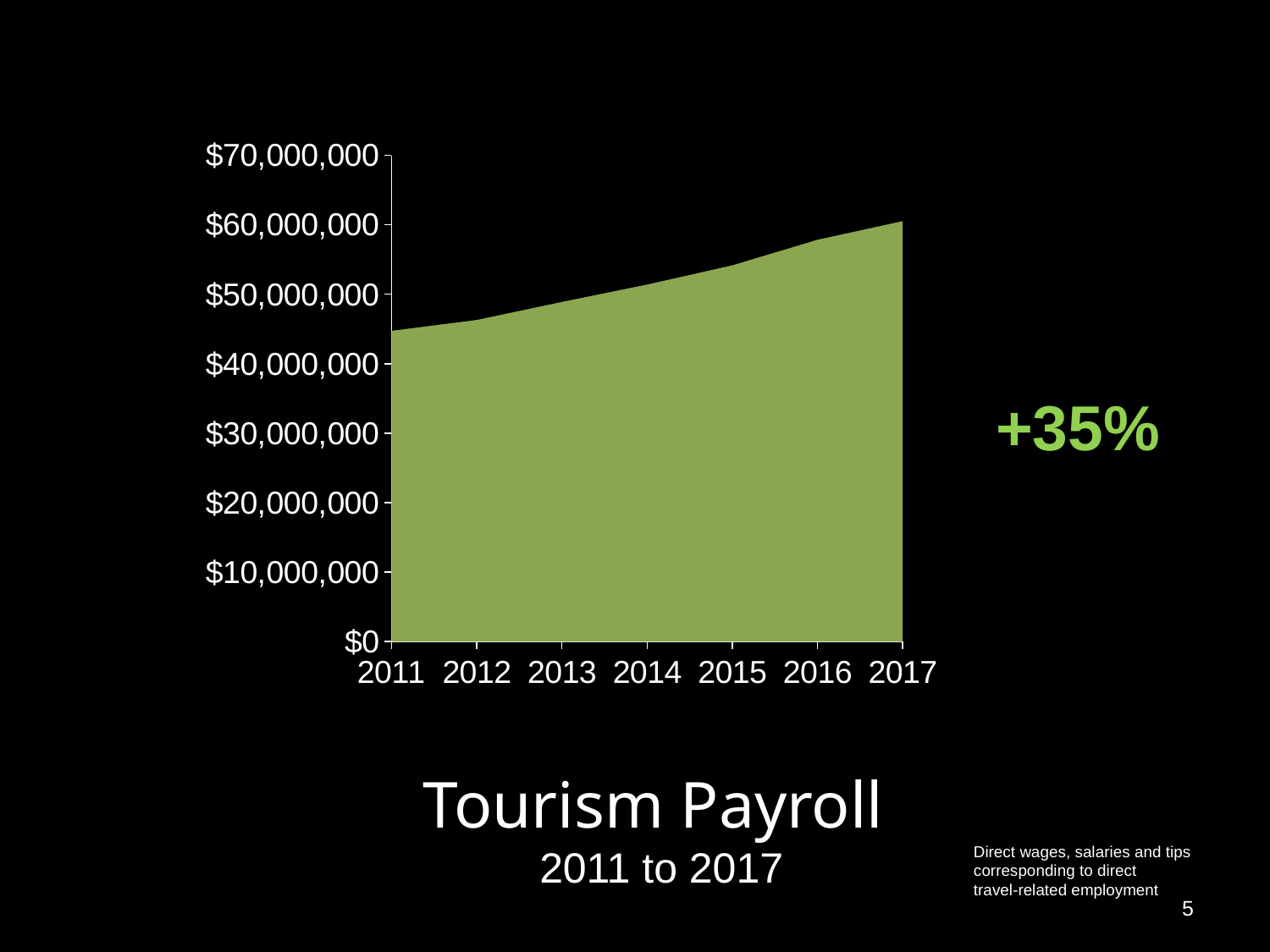
Which year has the highest tourism payroll? 2017 How many years are plotted along the x axis? 7 What is the title of the chart? Tourism Payroll 2011 to 2017 Which year has the lowest tourism payroll? 2011 What percentage change is annotated next to the chart? +35% Is the value for 2014 greater or less than $60,000,000? less Is the value for 2012 greater or less than $50,000,000? less Is the value for 2011 greater or less than $40,000,000? greater Which year has the larger tourism payroll, 2011 or 2017? 2017 Do the values rise or fall from 2011 to 2017? rise What kind of chart is shown on the slide? area chart